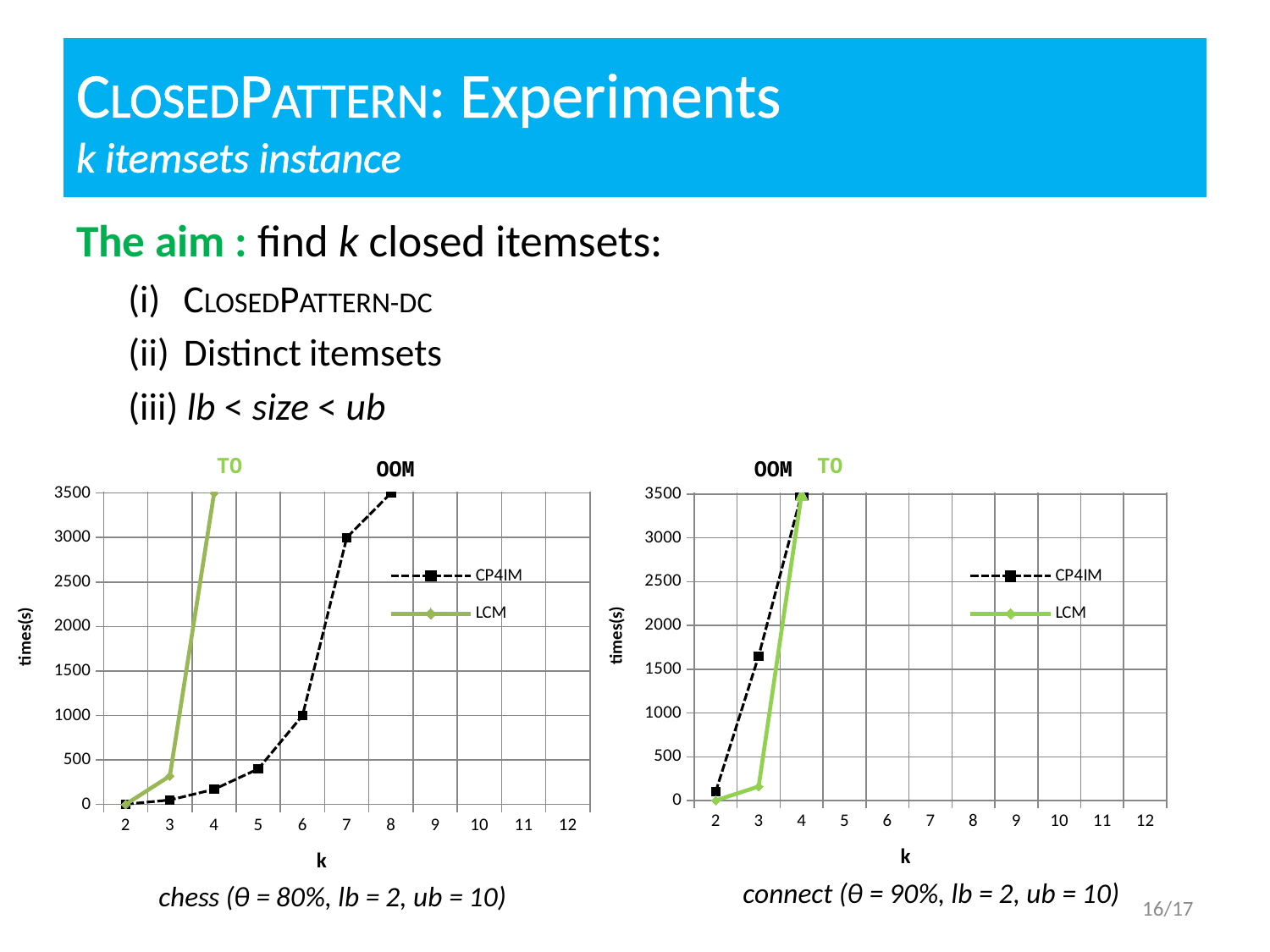
What are the two series named in the legend of the chess chart? CP4IM and LCM In the chess chart, is the CP4IM value at k = 5 greater or less than 1000? less How many series does the legend of the connect chart on the right list? 2 In the connect chart, which series has the higher value at k = 3, CP4IM or LCM? CP4IM What kind of chart is the chess chart on the left? line chart In the connect chart, is the CP4IM value at k = 3 greater or less than 1500? greater In the chess chart, which series has the higher value at k = 3, CP4IM or LCM? LCM In the connect chart, is the LCM value at k = 3 greater or less than 500? less What is the label of the y axis on the connect chart? times(s) In the chess chart, do the CP4IM times rise or fall as k increases? rise